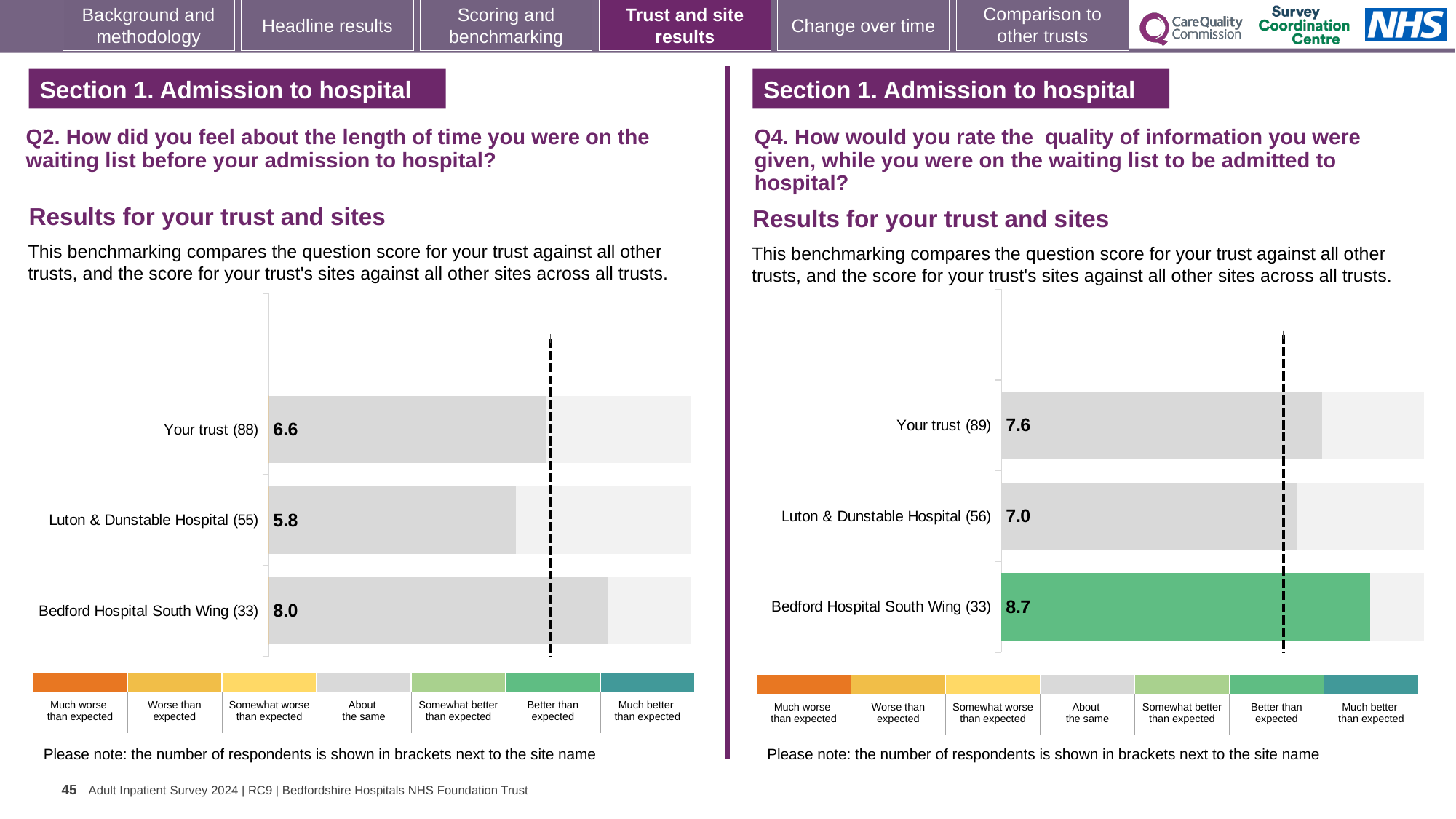
In the Q2 chart on the left, what is the score for Luton & Dunstable Hospital? 5.8 In the Q4 chart on the right, what is the score for Luton & Dunstable Hospital? 7.0 What type of chart is used in the Q2 chart on the left? Bar chart In the Q4 chart on the right, how many respondents are shown in brackets for Your trust? 89 In the Q2 chart on the left, what is the difference between the scores for Bedford Hospital South Wing and Luton & Dunstable Hospital? 2.2 In the Q4 chart on the right, what is the score for Bedford Hospital South Wing? 8.7 In the Q2 chart on the left, which site or trust has the highest score? Bedford Hospital South Wing In the Q4 chart on the right, which has the larger score, Your trust or Luton & Dunstable Hospital? Your trust In the Q2 chart on the left, which site or trust has the lowest score? Luton & Dunstable Hospital How many bars are plotted in the Q4 chart on the right? 3 In the Q4 chart on the right, what is the difference between the scores for Your trust and Bedford Hospital South Wing? 1.1 In the Q2 chart on the left, what is the score for Your trust? 6.6